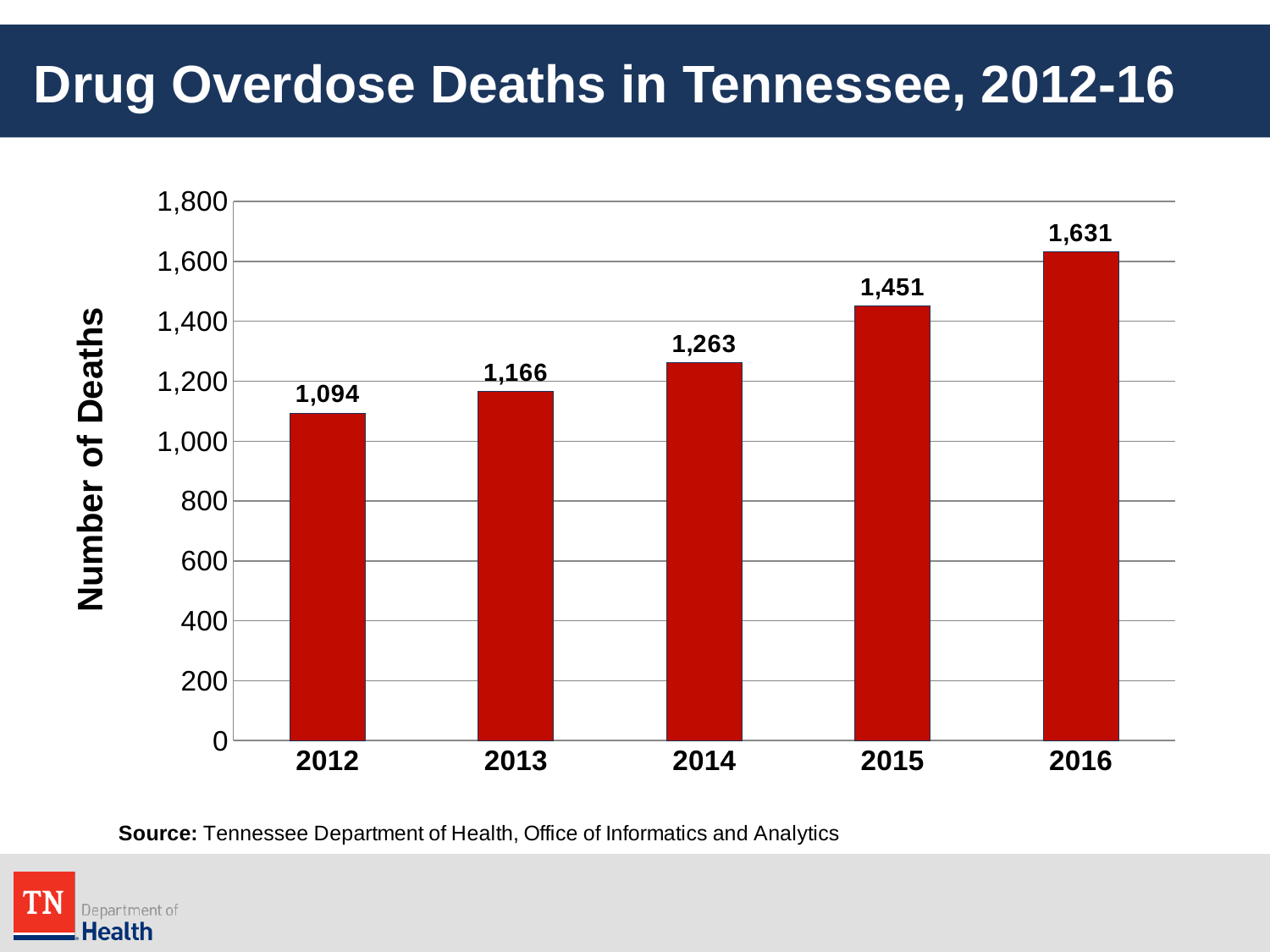
Which year has the highest number of deaths? 2016 What is the number of deaths shown for 2016? 1,631 Do the number of deaths rise or fall from 2012 to 2016? Rise Which year had more deaths, 2013 or 2015? 2015 Is the value for 2015 greater or less than 1,400? greater What is the difference in the number of deaths between 2016 and 2012? 537 What is the number of deaths shown for 2014? 1,263 How many years are shown on the x axis? 5 Which year has the lowest number of deaths? 2012 What kind of chart is shown on the slide? Bar chart How many drug overdose deaths were there in Tennessee in 2012? 1,094 How many more deaths were there in 2015 than in 2014? 188